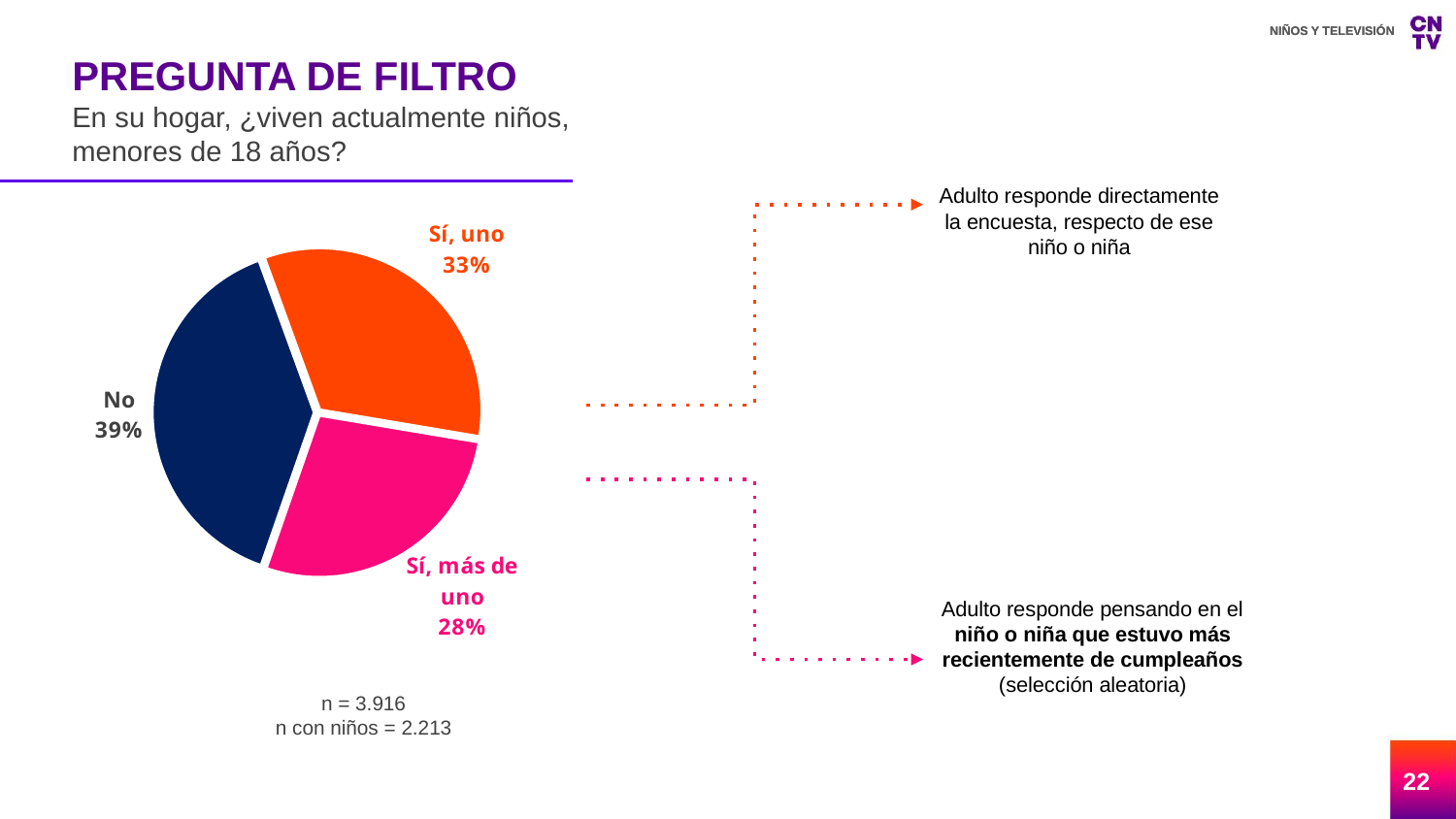
What kind of chart is shown on the slide? pie chart What is the difference in percentage points between the "Sí, uno" slice and the "Sí, más de uno" slice? 5 What colour is the "No" slice of the pie chart? dark navy blue What percentage of the pie chart is labelled "No"? 39% What percentage of the pie chart is labelled "Sí, uno"? 33% Which slice of the pie chart is the smallest? Sí, más de uno Which slice of the pie chart is the largest? No What is the sample size (n) shown below the pie chart? 3.916 How many slices does the pie chart have? 3 What percentage of the pie chart is labelled "Sí, más de uno"? 28% Which is larger in the pie chart, "Sí, uno" or "Sí, más de uno"? Sí, uno What is the difference in percentage points between the "No" slice and the "Sí, más de uno" slice? 11